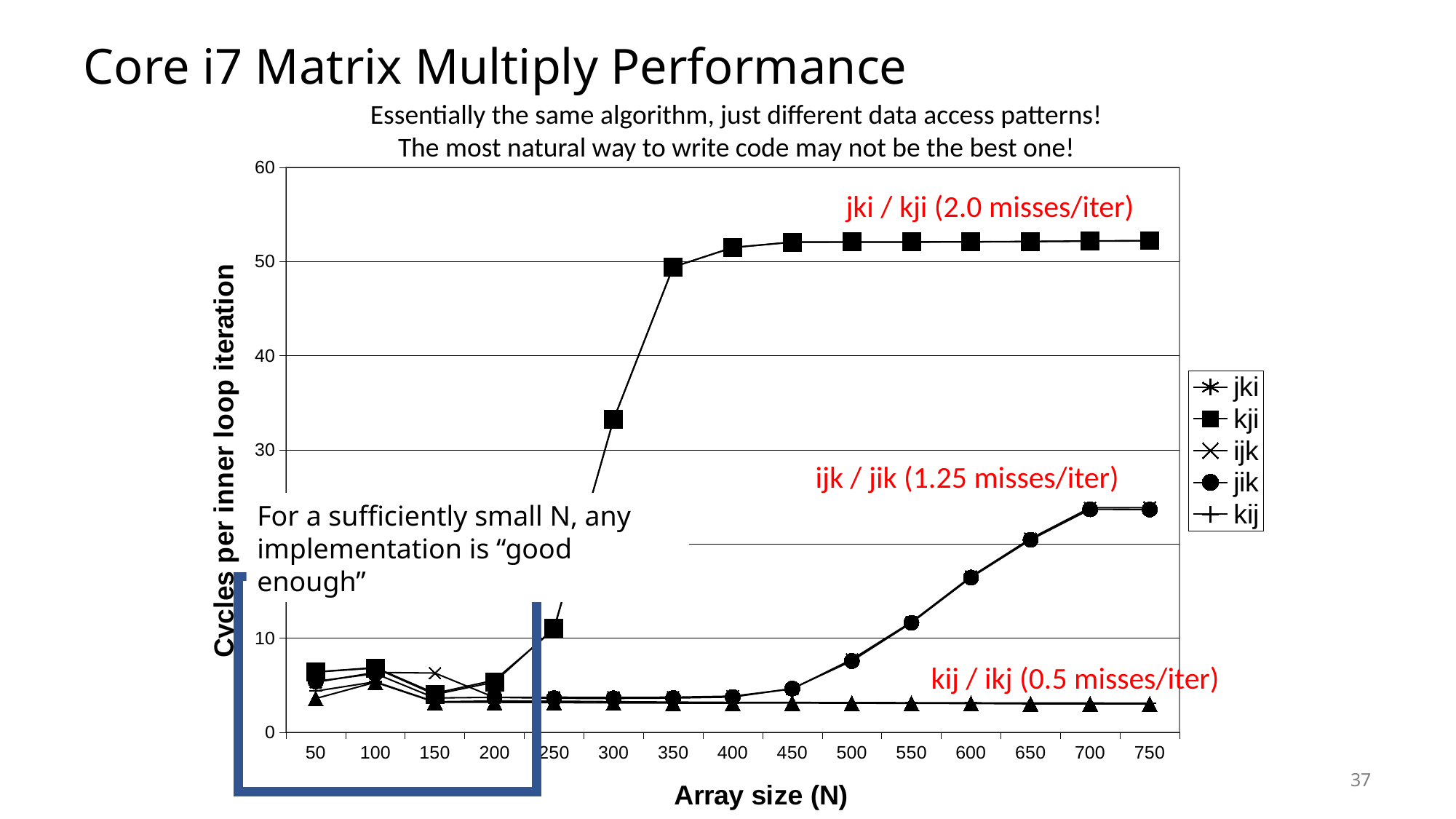
Is the value for kji at array size 750 greater or less than 50? greater Is the value for jik at array size 500 greater or less than 10? less What is the title of the x axis? Array size (N) Do the values for kji rise or fall as the array size increases from 250 to 350? rise What kind of chart is shown on the slide? line chart At array size 750, which is larger, the value for kji or the value for kij? kji How many series does the legend list? 5 Is the value for jik at array size 700 greater or less than 20? greater How many array size values are shown along the x axis? 15 At array size 600, which is larger, the value for jik or the value for kij? jik